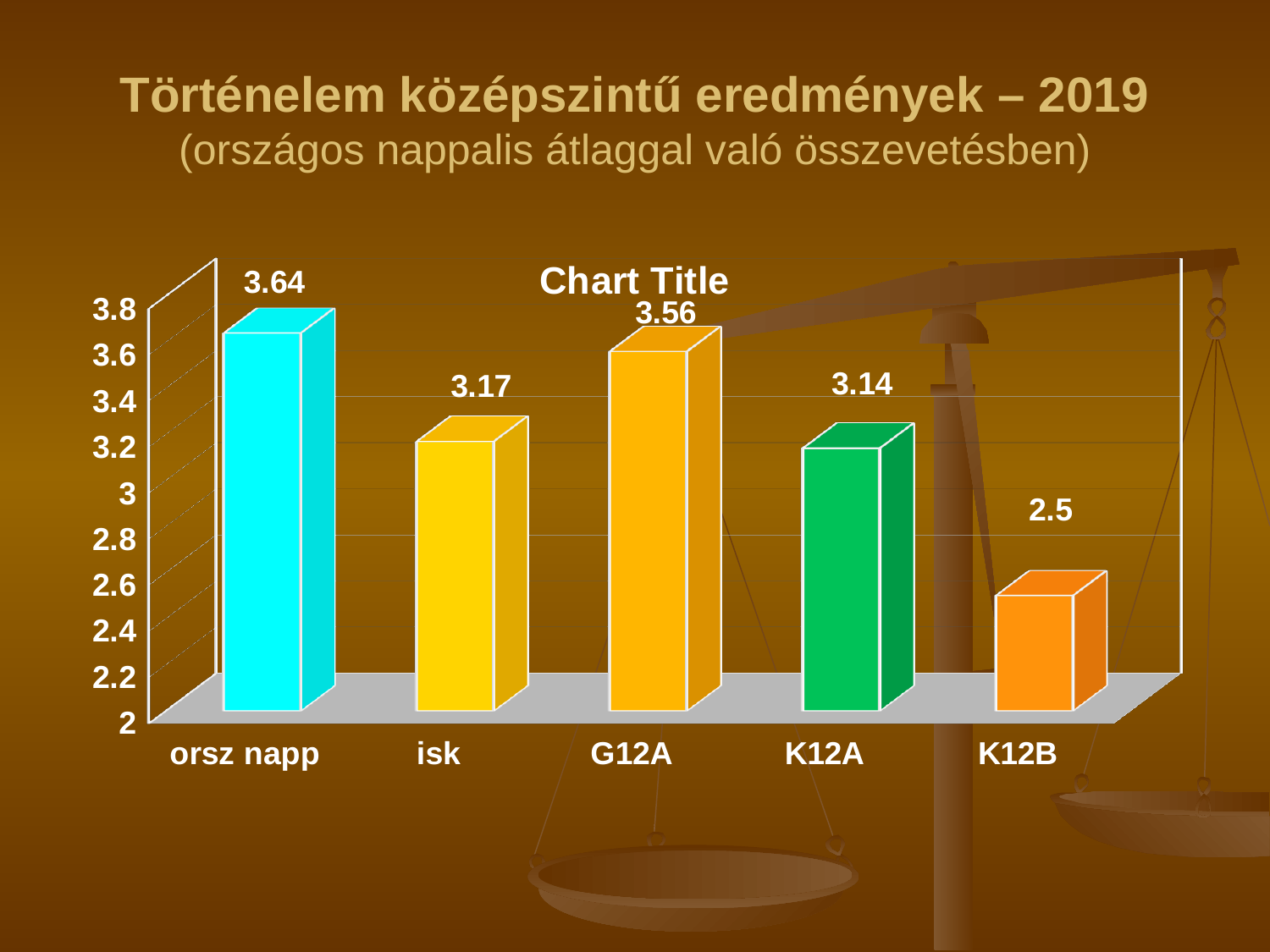
Is the value for K12A greater or less than 3? greater What is the difference between the values for G12A and K12B? 1.06 What is the value for orsz napp? 3.64 What kind of chart is shown on the slide? bar chart Which category has the highest value? orsz napp Which category has the lowest value? K12B What is the value for G12A? 3.56 What is the value for K12B? 2.5 How many categories are shown on the x axis? 5 What is the difference between the values for orsz napp and isk? 0.47 What is the title printed above the chart area? Chart Title Which is larger, the value for isk or the value for K12A? isk